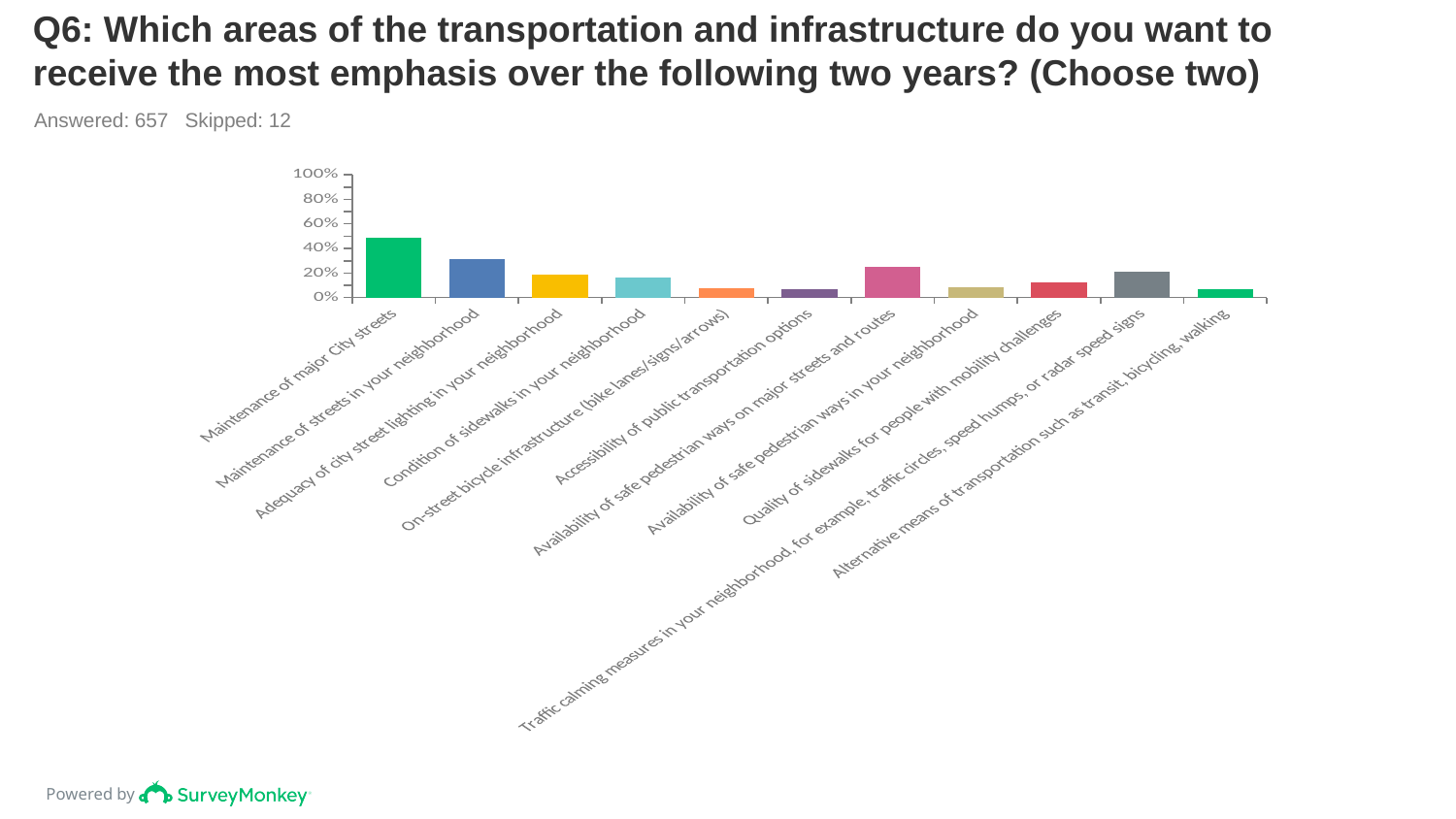
Which is larger: the value for Maintenance of streets in your neighborhood or the value for Adequacy of city street lighting in your neighborhood? Maintenance of streets in your neighborhood How many categories (bars) are plotted in the chart? 11 Which is larger: the value for Availability of safe pedestrian ways on major streets and routes or the value for Availability of safe pedestrian ways in your neighborhood? Availability of safe pedestrian ways on major streets and routes Is the value for Maintenance of streets in your neighborhood greater or less than 20%? greater Is the value for Traffic calming measures in your neighborhood, for example, traffic circles, speed humps, or radar speed signs greater or less than 40%? less Is the value for Accessibility of public transportation options greater or less than 20%? less Which category has the highest value in the chart? Maintenance of major City streets Which is larger: the value for Quality of sidewalks for people with mobility challenges or the value for Maintenance of major City streets? Maintenance of major City streets What is the highest percentage shown on the vertical axis of the chart? 100% How many respondents answered this question according to the slide? 657 What kind of chart is shown on the slide? bar chart